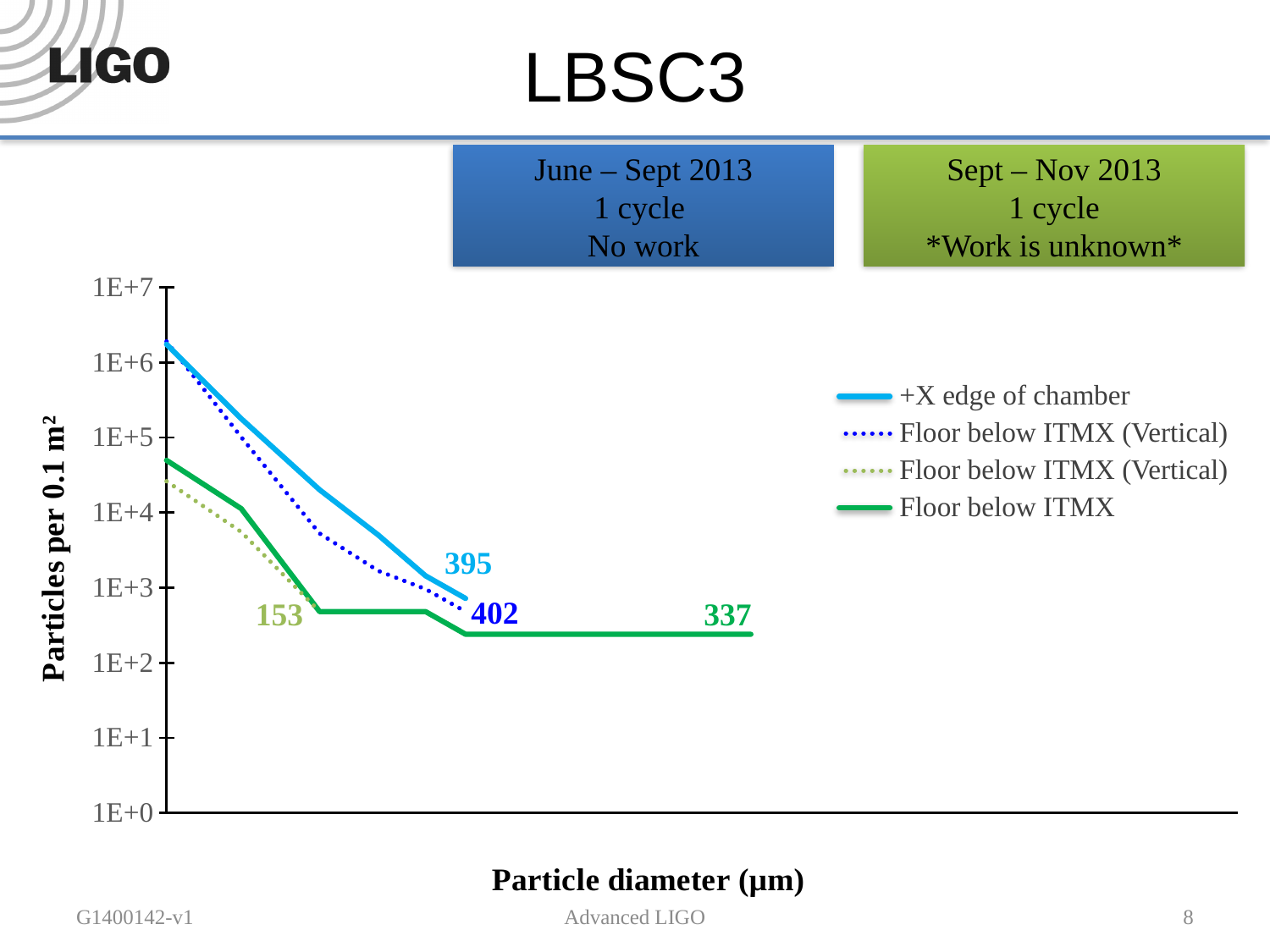
What is the data label printed at the end of the +X edge of chamber line? 395 Do the values of the +X edge of chamber line rise or fall as particle diameter increases along the x axis? fall What is the difference between the labelled values 402 and 395? 7 Which is larger, the labelled value for +X edge of chamber (395) or the labelled value on the blue dotted line (402)? 402 What is the title of the y axis? Particles per 0.1 m² What is the data label printed on the solid green Floor below ITMX line? 337 How many series does the legend list? 4 What kind of chart is shown on the slide? line chart Is the starting value of the +X edge of chamber line greater or less than 1E+6? greater What is the data label printed at the end of the blue dotted Floor below ITMX (Vertical) line? 402 What is the difference between the labelled value for +X edge of chamber (395) and the labelled value for Floor below ITMX (337)? 58 What is the data label printed at the end of the green dotted Floor below ITMX (Vertical) line? 153